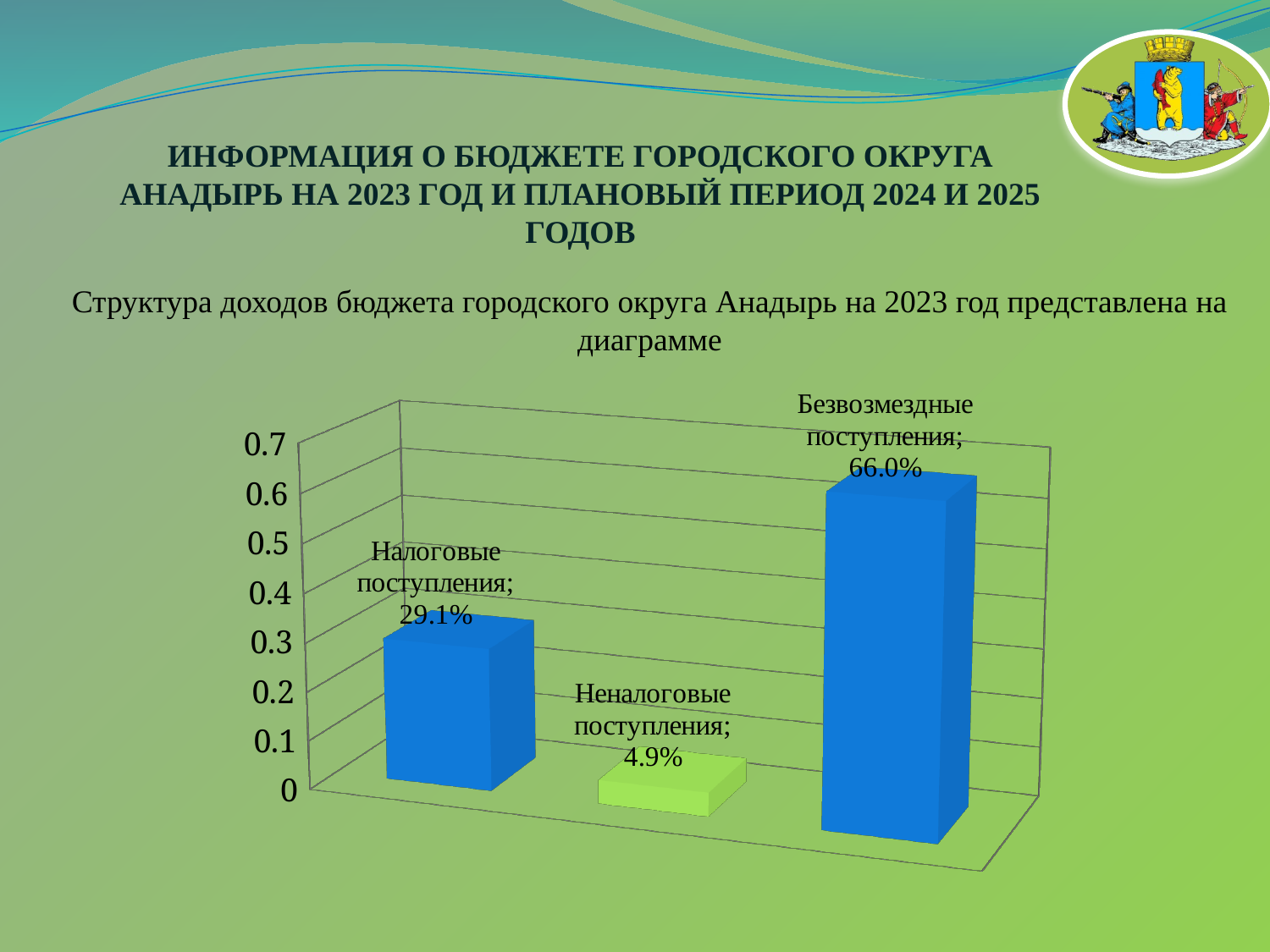
What is the difference between Безвозмездные поступления and Налоговые поступления? 36.9% Which category has the highest value? Безвозмездные поступления Is the value for Безвозмездные поступления greater or less than 0.5? greater How many categories are shown in the chart? 3 What is the highest value shown on the vertical axis? 0.7 What is the value for Налоговые поступления? 29.1% Which is larger, Налоговые поступления or Неналоговые поступления? Налоговые поступления Which category has the lowest value? Неналоговые поступления What is the value for Безвозмездные поступления? 66.0% What is the value for Неналоговые поступления? 4.9% What kind of chart is shown on the slide? bar chart What is the difference between Налоговые поступления and Неналоговые поступления? 24.2%